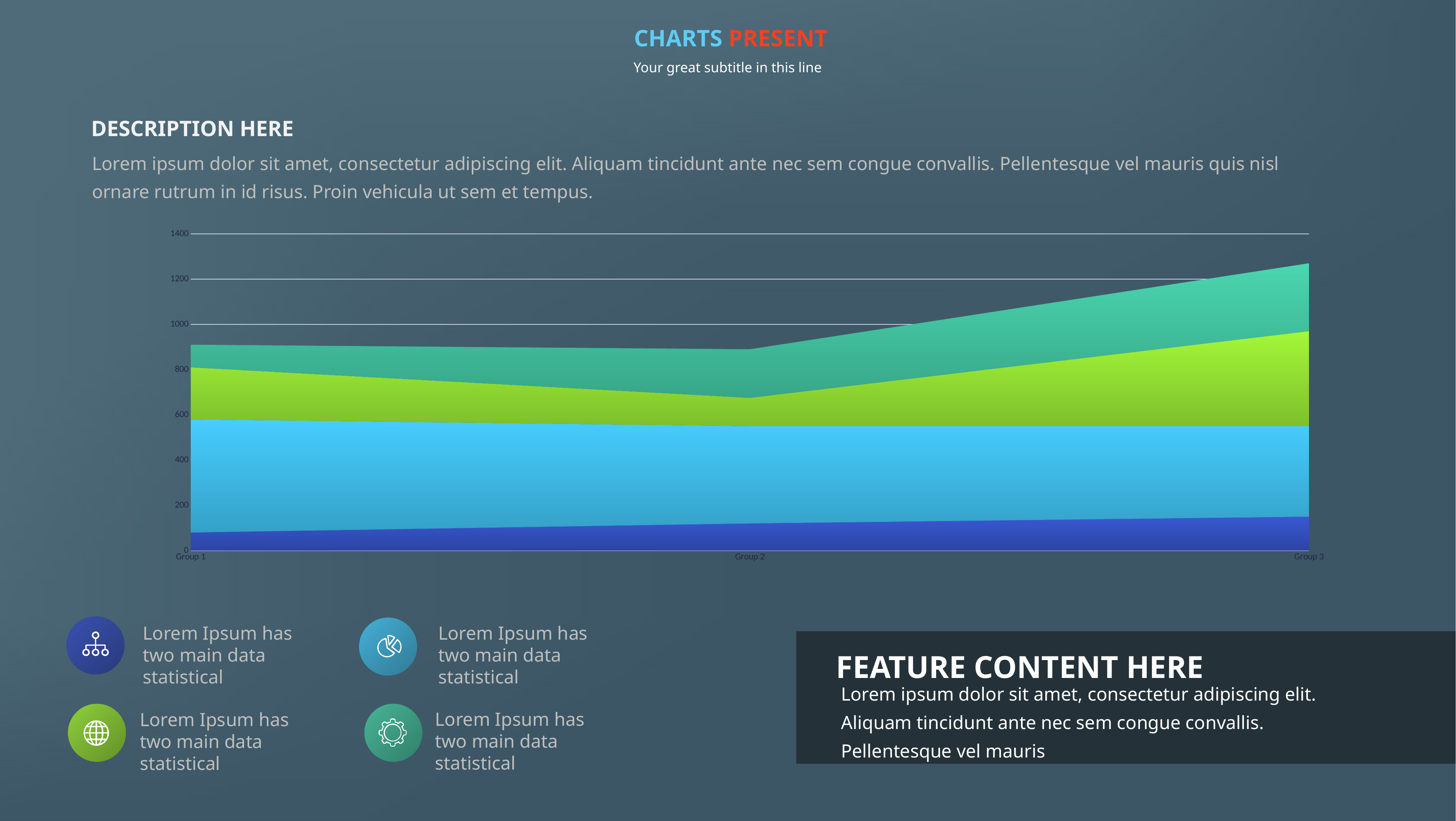
What is the highest value shown on the y axis of the chart? 1400 Is the stacked total for Group 2 greater or less than 1000? less How many coloured bands are stacked in the chart? 4 What are the category labels on the x axis of the chart? Group 1, Group 2, Group 3 What kind of chart is shown on the slide? Stacked area chart Is the stacked total for Group 1 greater or less than 1000? less How many categories are shown on the x axis of the chart? 3 Is the stacked total for Group 3 larger or smaller than the stacked total for Group 2? larger Is the value of the bottom (dark blue) band at Group 1 greater or less than 200? less Which category has the highest stacked total in the chart? Group 3 Does the stacked total rise or fall from Group 2 to Group 3? rise